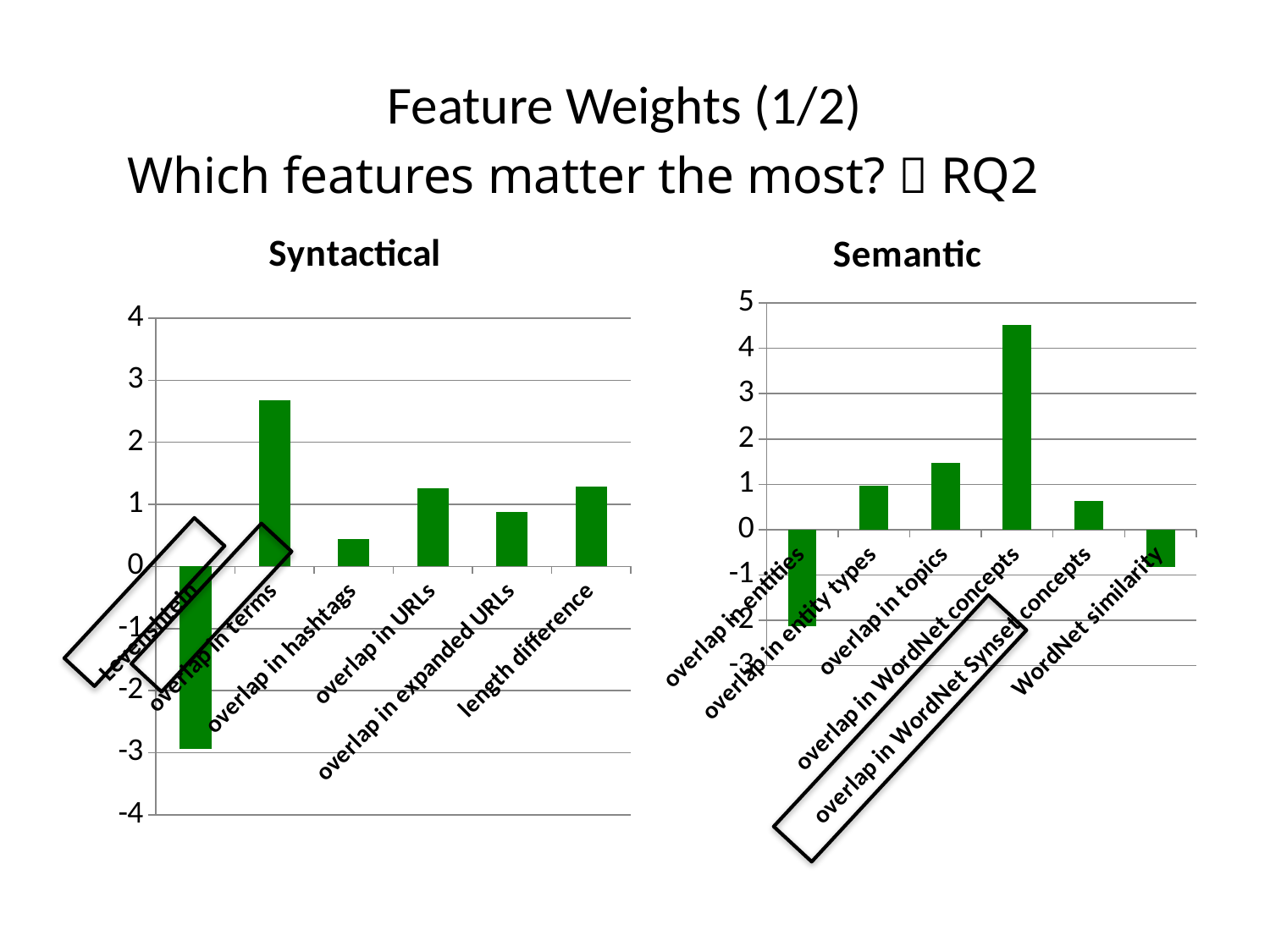
In the Semantic chart, which feature has the lowest weight? overlap in entities In the Syntactical chart, which feature has the lowest weight? Levenshtein What are the titles of the two charts on the slide? Syntactical and Semantic How many categories does the Syntactical chart show? 6 In the Syntactical chart, which feature has the highest weight? overlap in terms In the Syntactical chart, which is larger: the value for overlap in URLs or the value for overlap in hashtags? overlap in URLs In the Semantic chart, is the value for overlap in WordNet concepts greater or less than 4? greater In the Semantic chart, which feature has the highest weight? overlap in WordNet concepts In the Syntactical chart, is the value for overlap in hashtags greater or less than 1? less How many categories does the Semantic chart show? 6 What kind of chart is the Syntactical chart? bar chart In the Semantic chart, is the value for overlap in entities greater or less than -2? less